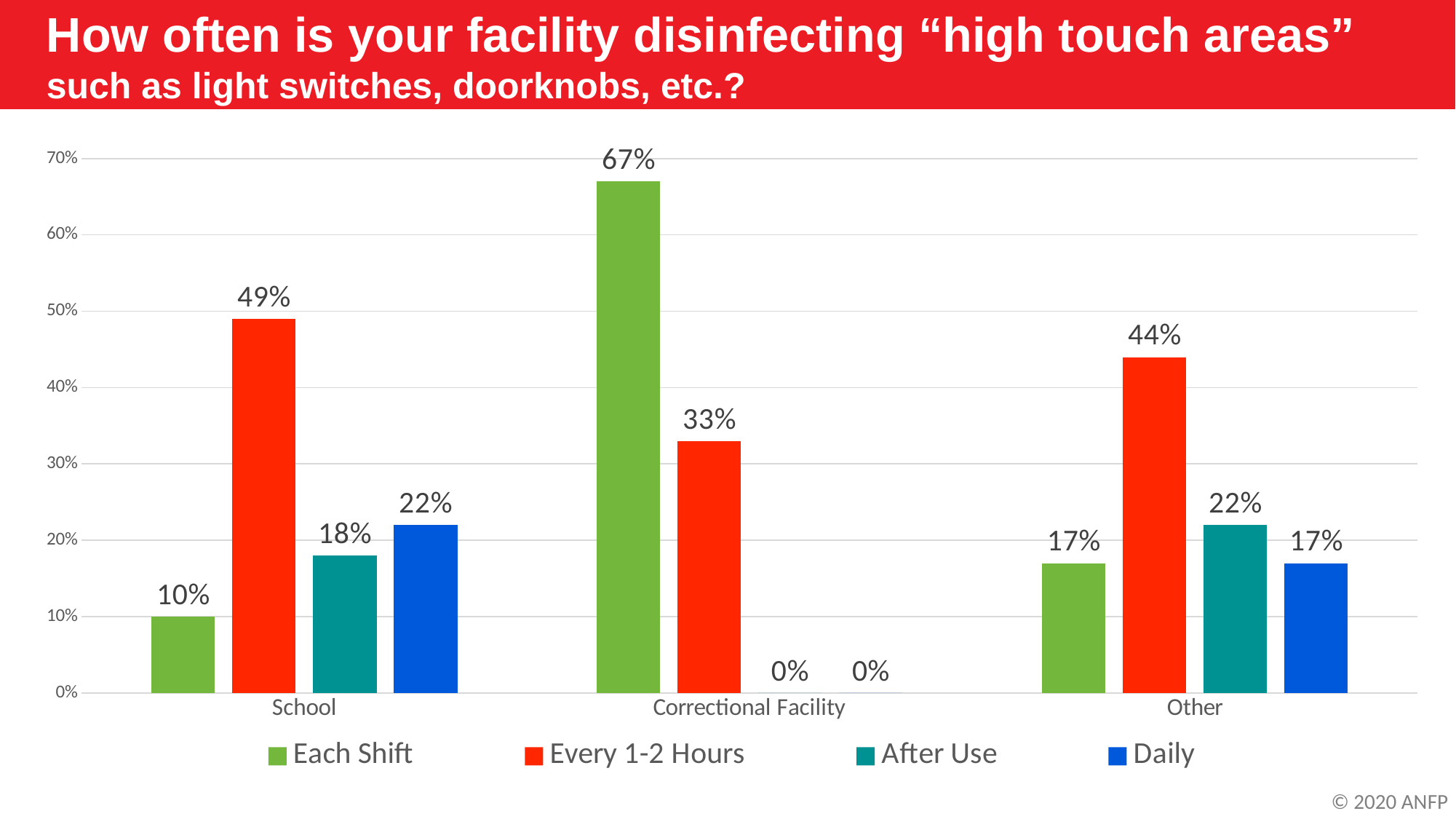
How many series does the legend list? 4 What is the difference between the Every 1-2 Hours values for School and Other? 5% What percentage of schools disinfect high touch areas every 1-2 hours? 49% What is the value for Each Shift in the Correctional Facility category? 67% Which category has the highest value for Each Shift? Correctional Facility Which category has the lowest value for Every 1-2 Hours? Correctional Facility What is the value for After Use in the Other category? 22% What kind of chart is shown on the slide? Bar chart How many facility categories are shown on the x axis? 3 What is the value for Daily in the School category? 22% Which is larger: the Each Shift value for School or the Each Shift value for Other? Other Which colour represents the After Use series in the legend? Teal